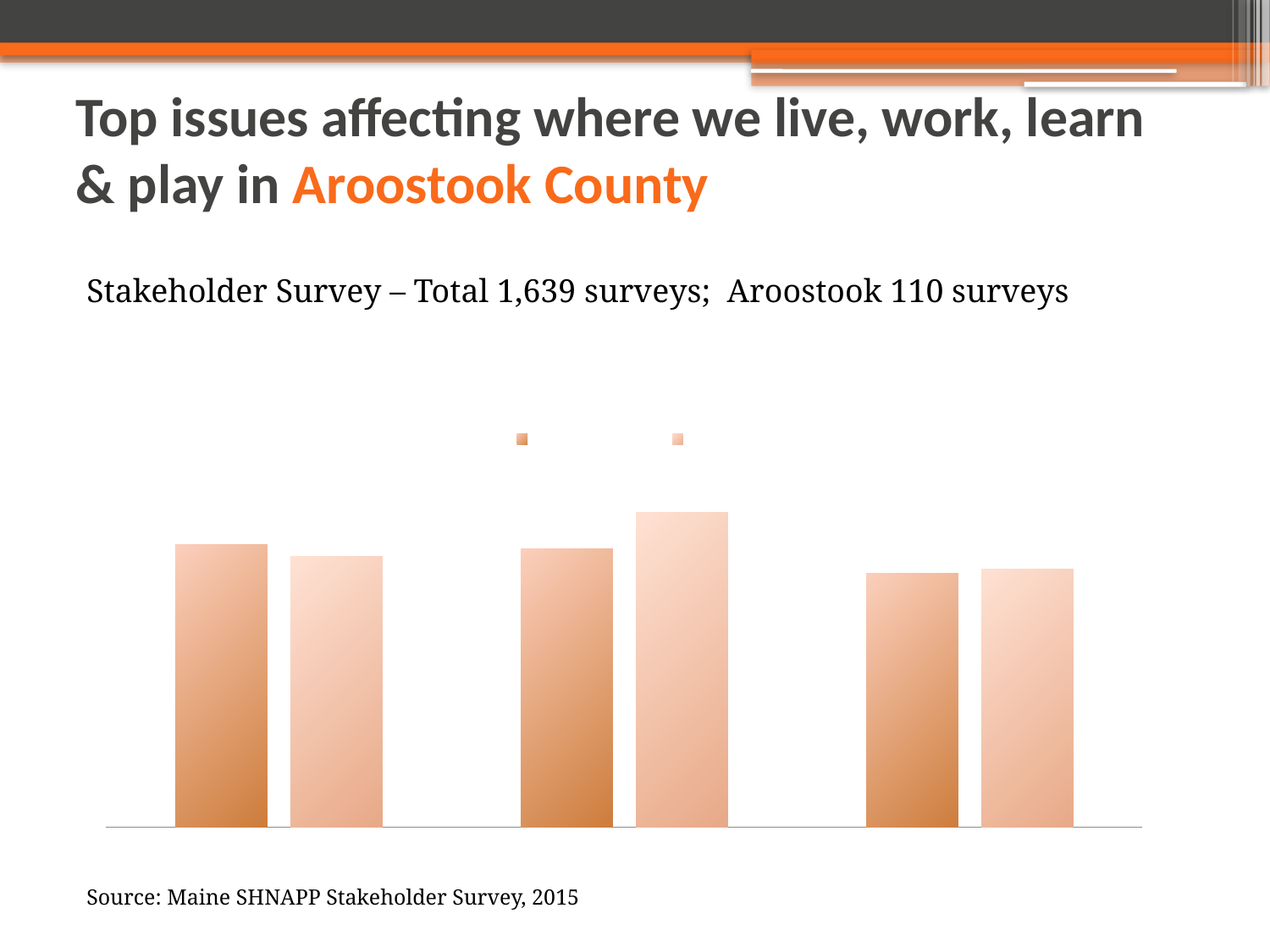
Does the chart display any numeric axis labels or data labels? No In the left-most group of bars, which bar is taller, the darker orange bar or the lighter orange bar? the darker orange bar In the middle group of bars, which bar is taller, the darker orange bar or the lighter orange bar? the lighter orange bar How many series does the chart's legend list? 2 Which group of bars contains the tallest bar on the chart? the middle group How many groups of bars does the chart show? 3 How many bars are plotted in total on the chart? 6 What kind of chart is shown on the slide? bar chart Are the bars on the chart vertical or horizontal? vertical Which group of bars contains the shortest bar on the chart? the right-most group